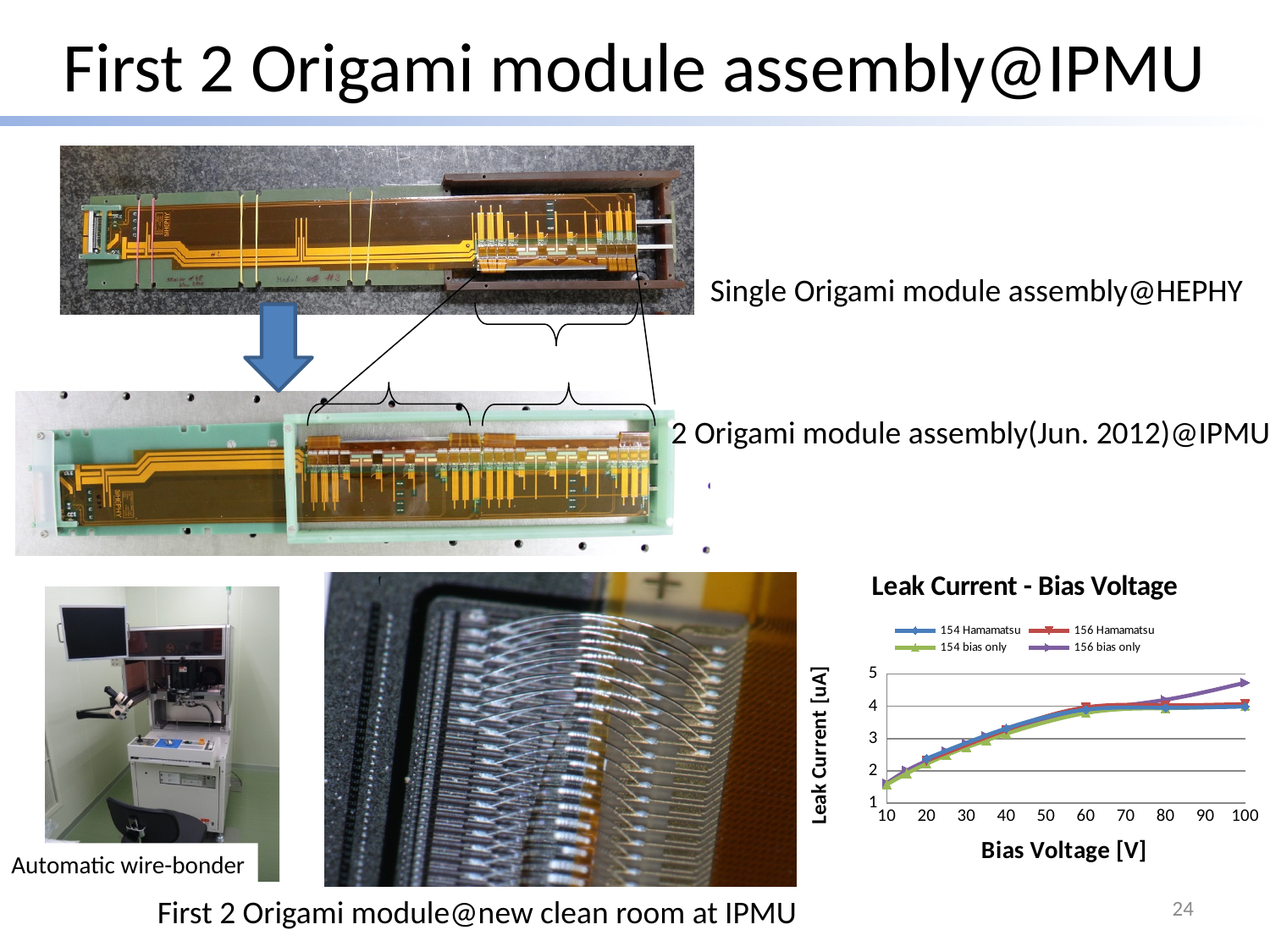
What is the x-axis label of the Leak Current - Bias Voltage chart? Bias Voltage [V] In the Leak Current - Bias Voltage chart, is the value for 156 bias only at 100 V greater or less than 4? greater In the Leak Current - Bias Voltage chart, is the value for 154 bias only at 40 V greater or less than 4? less How many series does the legend of the Leak Current - Bias Voltage chart list? 4 In the Leak Current - Bias Voltage chart, is the value for 156 bias only at 100 V larger or smaller than the value for 154 Hamamatsu at 100 V? larger In the Leak Current - Bias Voltage chart, which series has the highest leak current at 100 V? 156 bias only What kind of chart is the Leak Current - Bias Voltage chart? line chart What is the title of the chart on the slide? Leak Current - Bias Voltage In the Leak Current - Bias Voltage chart, is the value for 156 Hamamatsu at 60 V greater or less than 3? greater In the Leak Current - Bias Voltage chart, does the leak current rise or fall as the bias voltage increases? rise